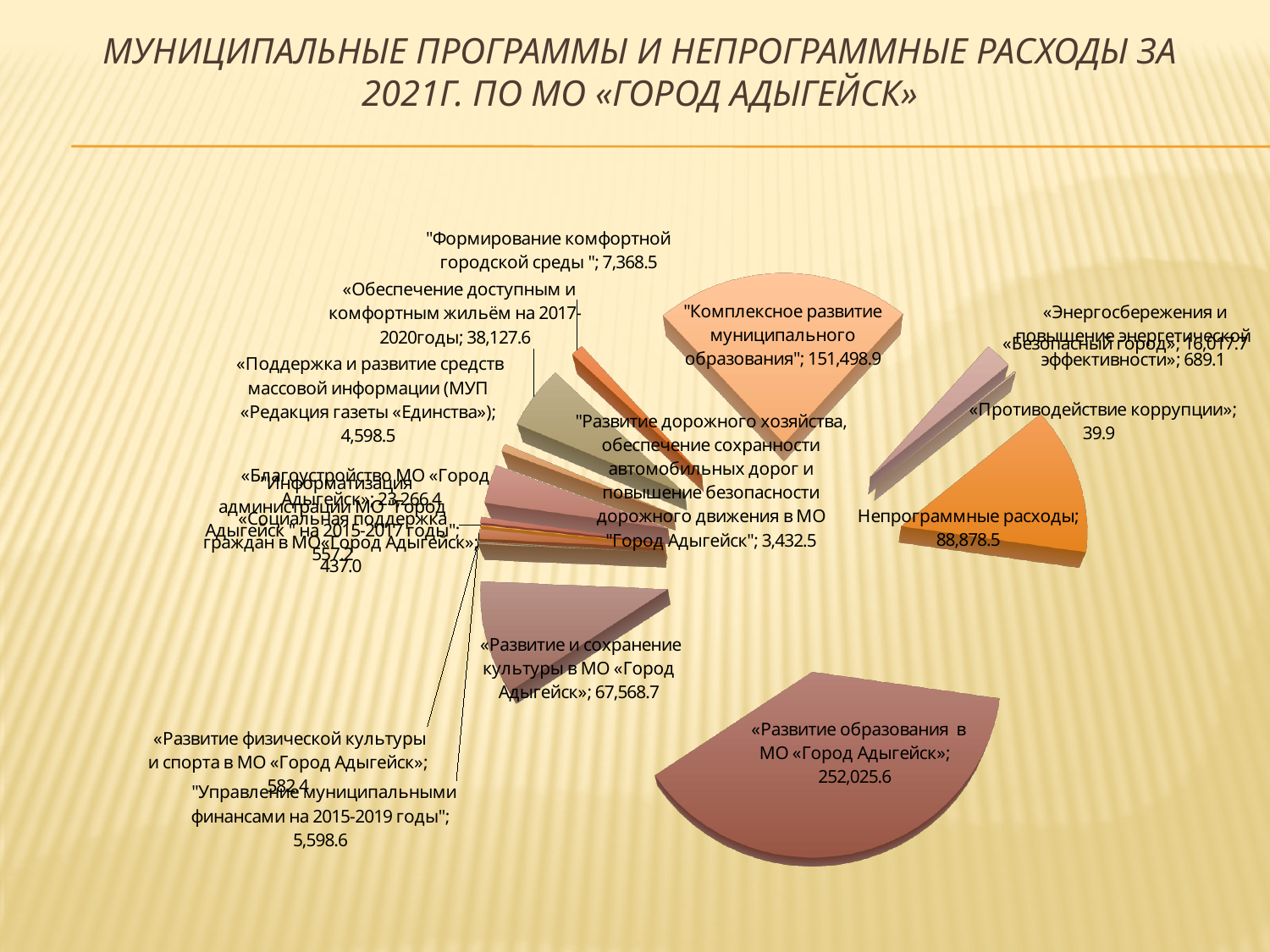
Which category has the largest slice of the pie? «Развитие образования в МО «Город Адыгейск» What kind of chart is shown on the slide? pie chart What is the value for Непрограммные расходы? 88,878.5 What is the value for «Развитие образования в МО «Город Адыгейск»? 252,025.6 What is the difference between «Развитие образования в МО «Город Адыгейск» and "Комплексное развитие муниципального образования"? 100,526.7 What is the title of the slide? Муниципальные программы и непрограммные расходы за 2021г. по МО «Город Адыгейск» Which category has the smallest value? «Противодействие коррупции» What is the value for «Противодействие коррупции»? 39.9 What is the value for "Комплексное развитие муниципального образования"? 151,498.9 Which is larger: Непрограммные расходы or «Развитие и сохранение культуры в МО «Город Адыгейск»? Непрограммные расходы What is the value for "Управление муниципальными финансами на 2015-2019 годы"? 5,598.6 What is the value for «Развитие и сохранение культуры в МО «Город Адыгейск»? 67,568.7